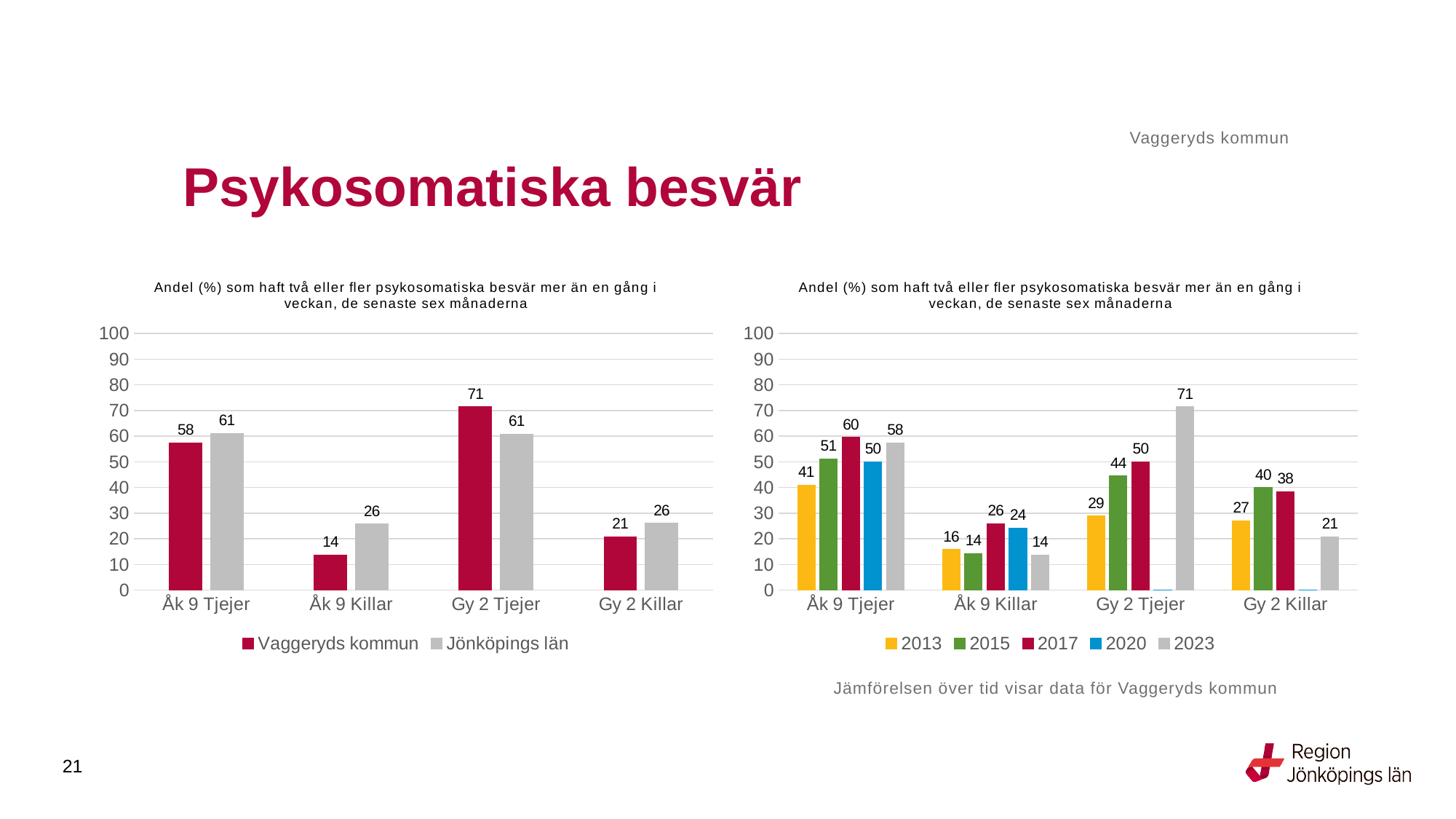
How many series does the legend of the right chart list? 5 In the left chart, which is larger for Åk 9 Killar: Vaggeryds kommun or Jönköpings län? Jönköpings län How many series does the legend of the left chart list? 2 What type of chart is the right chart? Bar chart In the left chart, what is the value for Jönköpings län for Åk 9 Killar? 26 In the right chart, what is the difference between 2013 and 2023 for Åk 9 Tjejer? 17 In the right chart, what is the value for 2017 for Åk 9 Tjejer? 60 In the left chart, what is the difference between Vaggeryds kommun and Jönköpings län for Gy 2 Tjejer? 10 In the left chart, what is the value for Vaggeryds kommun for Åk 9 Tjejer? 58 In the right chart, what is the value for 2023 for Gy 2 Tjejer? 71 In the left chart, which category has the highest value for Vaggeryds kommun? Gy 2 Tjejer In the right chart, which year has the lowest value for Gy 2 Killar? 2023